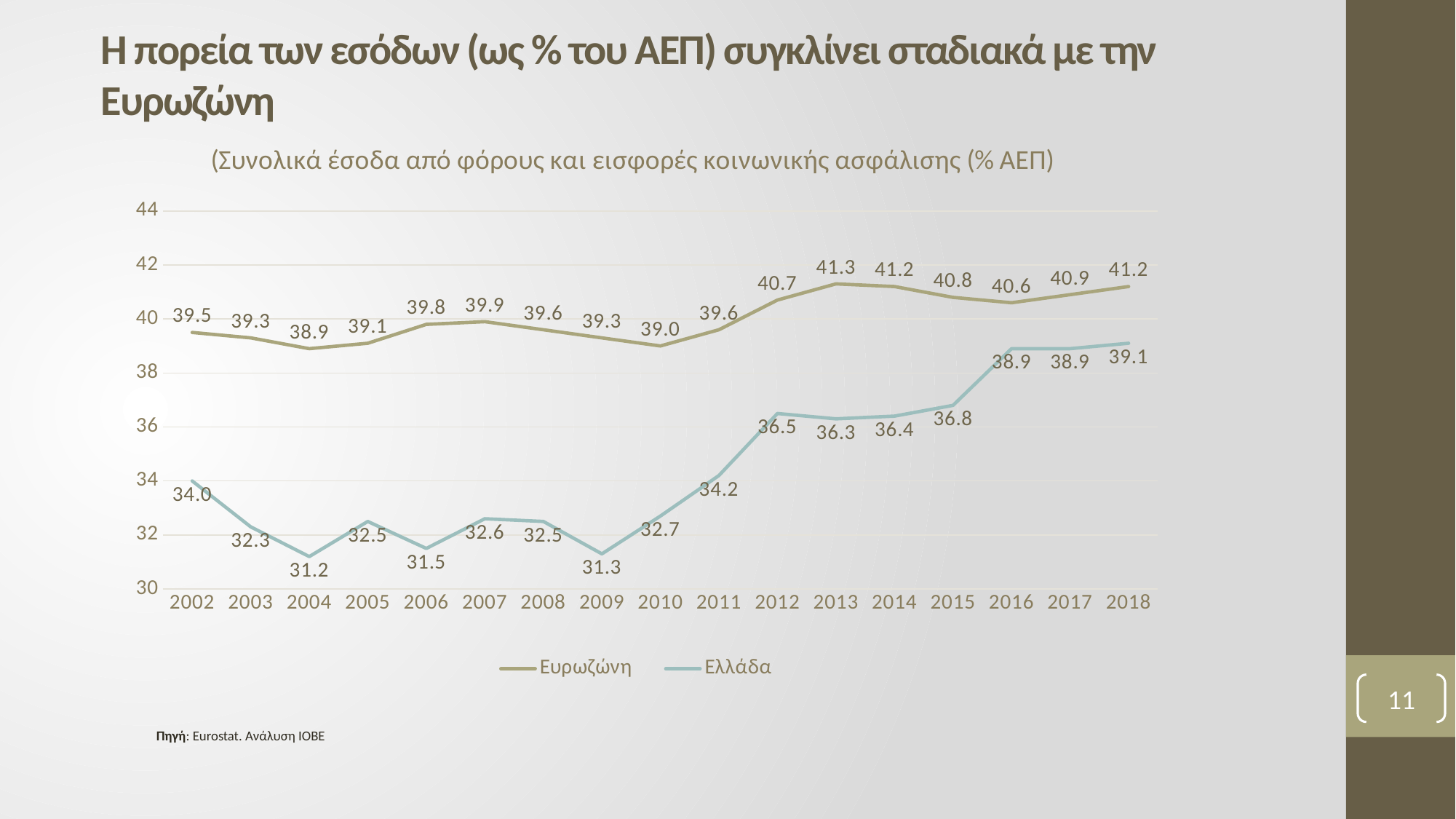
What is the difference between the Ευρωζώνη and Ελλάδα values in 2018? 2.1 What kind of chart is shown on the slide? Line chart How many series does the legend list? 2 What is the value for Ελλάδα in 2016? 38.9 What is the value for Ευρωζώνη in 2013? 41.3 Which series has the higher value in 2012, Ευρωζώνη or Ελλάδα? Ευρωζώνη What is the value for Ελλάδα in 2002? 34.0 Does the Ελλάδα series rise or fall from 2009 to 2018? Rise In which year does the Ευρωζώνη series reach its highest value? 2013 What is the difference between the Ευρωζώνη and Ελλάδα values in 2002? 5.5 In which year does the Ελλάδα series reach its lowest value? 2004 How many years are plotted on the x axis? 17